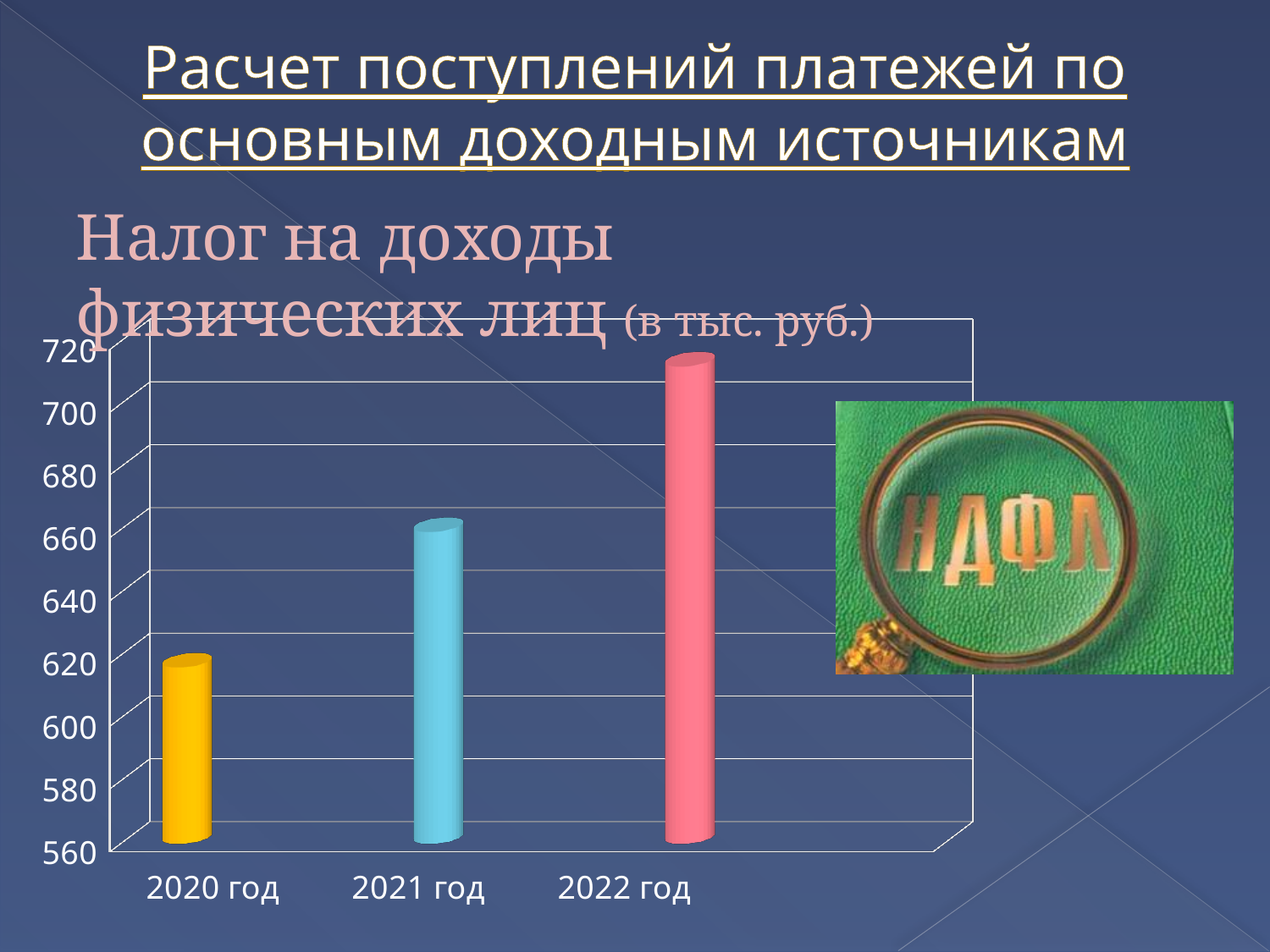
Is the value for 2020 год greater or less than 640? less Do the values rise or fall from 2020 год to 2022 год? rise Is the value for 2020 год greater or less than 600? greater What is the title of the chart? Налог на доходы физических лиц (в тыс. руб.) Which year has the highest value on the chart? 2022 год How many categories (years) are plotted on the chart? 3 Is the value for 2021 год greater or less than 680? less Which year has the lowest value on the chart? 2020 год Which is larger, the value for 2021 год or the value for 2020 год? 2021 год What kind of chart is shown on the slide? bar chart What is the highest value shown on the vertical axis of the chart? 720